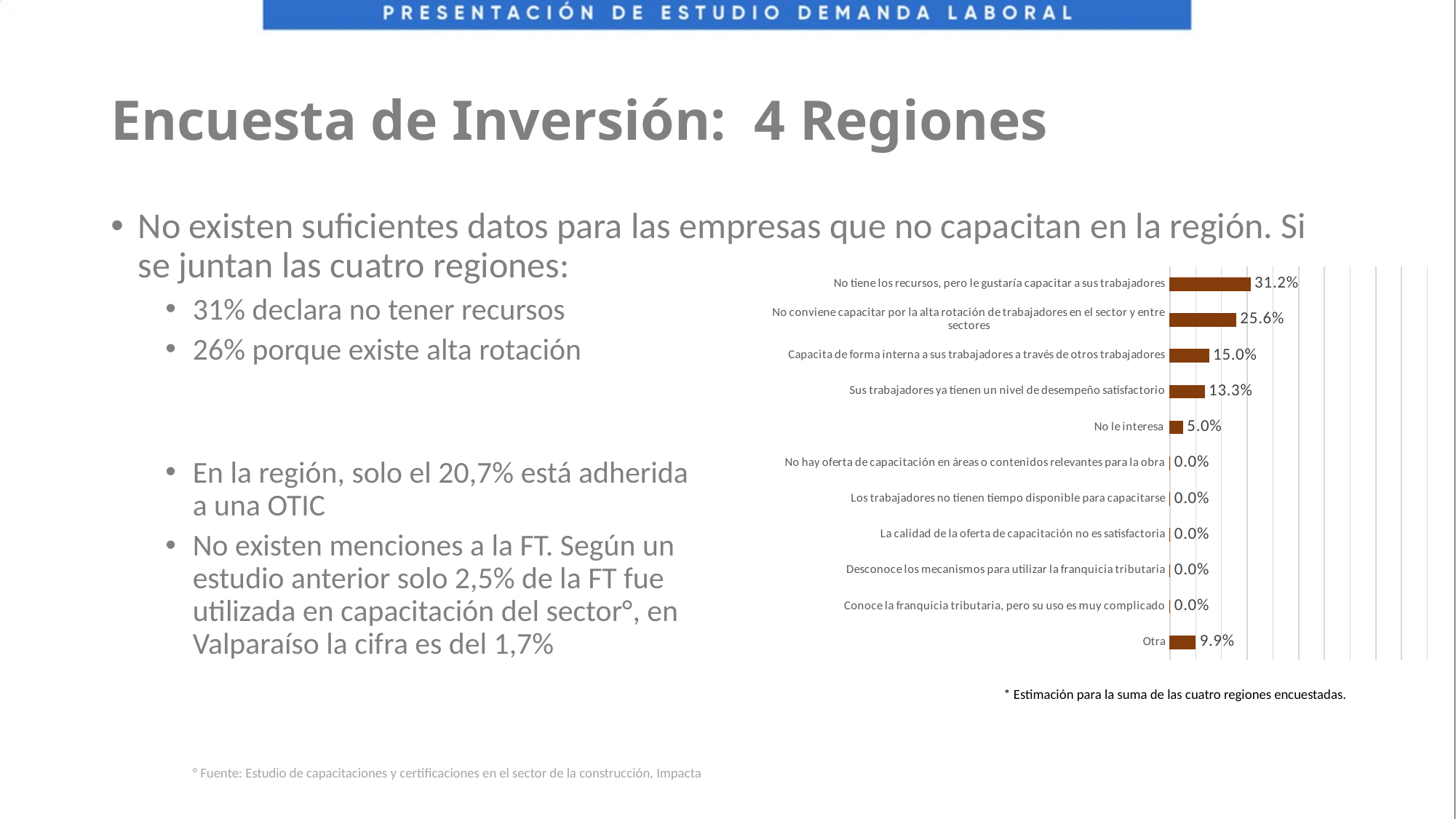
What is the difference between the values for "No tiene los recursos, pero le gustaría capacitar a sus trabajadores" and "No conviene capacitar por la alta rotación de trabajadores en el sector y entre sectores"? 5.6% How many categories does the chart show? 11 What is the value for "Capacita de forma interna a sus trabajadores a través de otros trabajadores"? 15.0% What is the value for "No le interesa"? 5.0% Which category has the highest value? No tiene los recursos, pero le gustaría capacitar a sus trabajadores Which is larger, the value for "Otra" or the value for "No le interesa"? Otra What is the difference between the values for "Capacita de forma interna a sus trabajadores a través de otros trabajadores" and "Sus trabajadores ya tienen un nivel de desempeño satisfactorio"? 1.7% What is the value for "Otra"? 9.9% How many categories have a value of 0.0%? 5 What colour are the bars in the chart? Brown What kind of chart is shown on the slide? Bar chart What is the value for "No tiene los recursos, pero le gustaría capacitar a sus trabajadores"? 31.2%